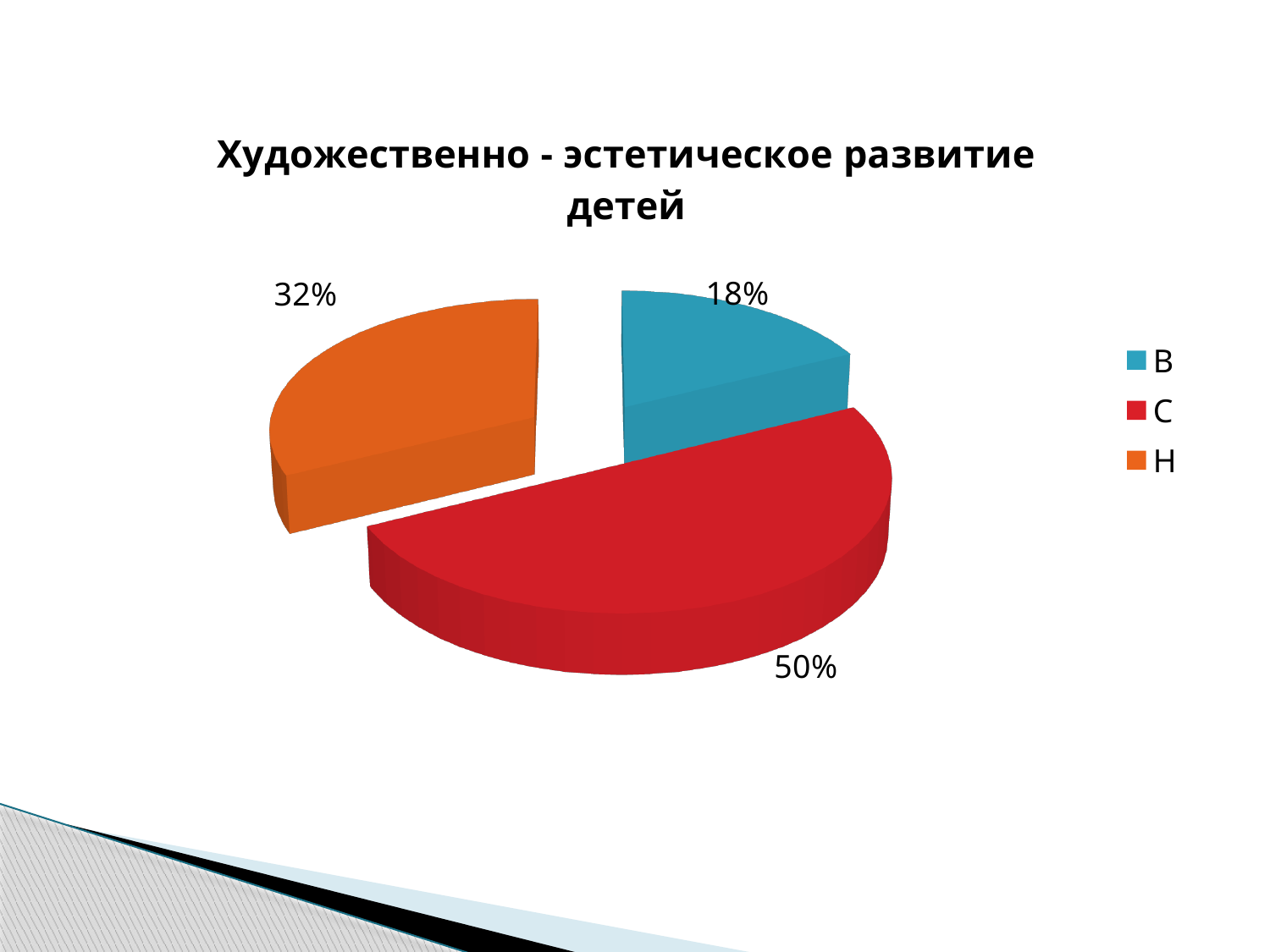
Which category has the largest slice of the pie? С How many slices does the pie chart have? 3 What is the title of the chart? Художественно - эстетическое развитие детей What colour is the slice for С? red How many entries does the legend list? 3 Which is larger, the slice for Н or the slice for В? Н What kind of chart is shown on the slide? pie chart What is the difference in percentage points between the С slice and the Н slice? 18 Which category has the smallest slice of the pie? В What share of the pie does the slice labelled Н have? 32% What share of the pie does the slice labelled С have? 50% What share of the pie does the slice labelled В have? 18%